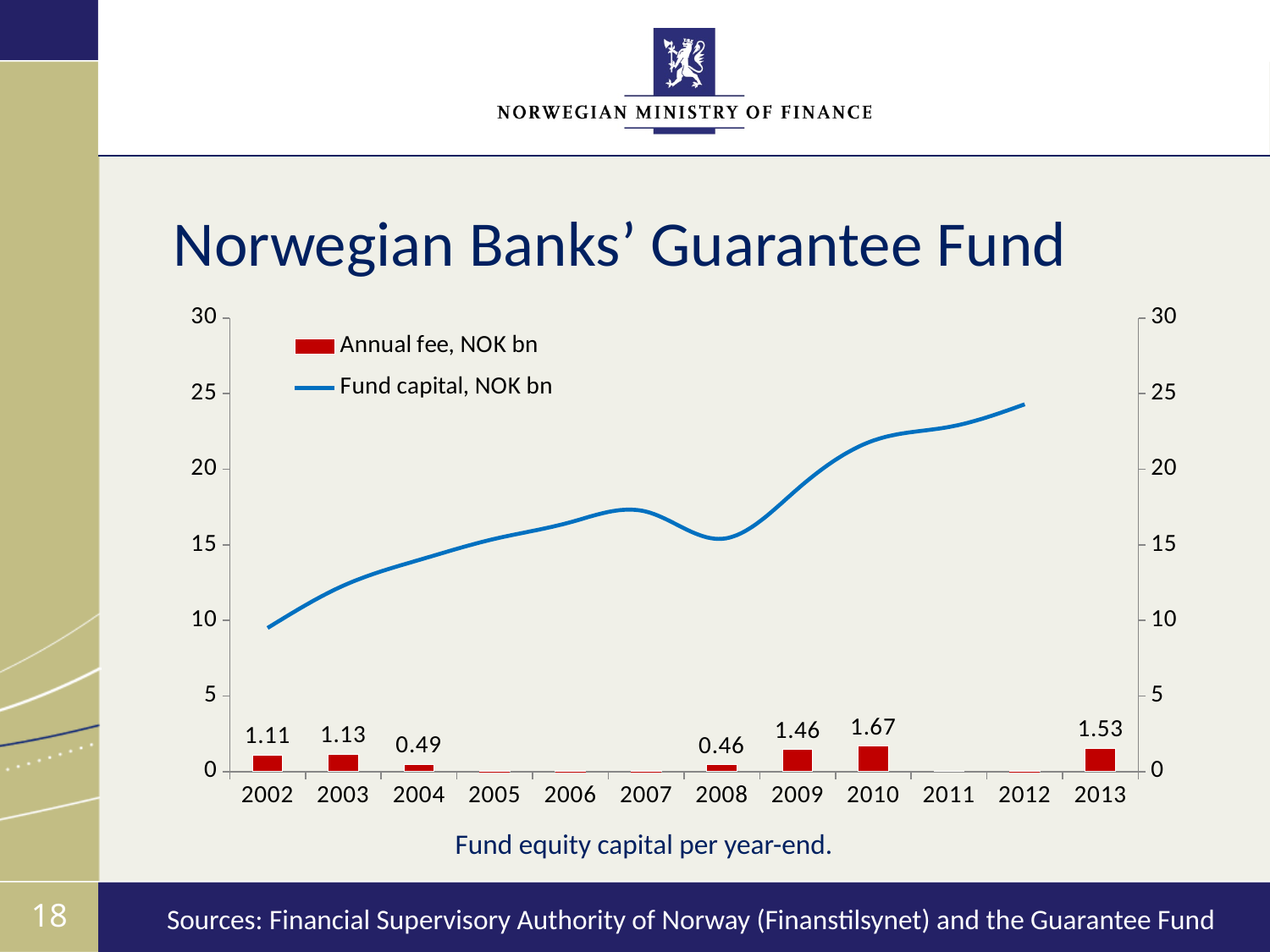
What is the annual fee, NOK bn, for 2010? 1.67 How many series does the legend list? 2 Among the labelled annual fee values, which year has the lowest? 2008 Which year has the highest labelled annual fee? 2010 What is the difference between the annual fee in 2010 and in 2009? 0.21 What is the annual fee, NOK bn, for 2013? 1.53 Which year has the larger annual fee, 2002 or 2003? 2003 Does the fund capital line rise or fall from 2002 to 2007? rise Is the fund capital value for 2002 greater or less than 10? less Is the fund capital value for 2012 greater or less than 20? greater What is the annual fee, NOK bn, for 2004? 0.49 How many years are shown on the x axis? 12